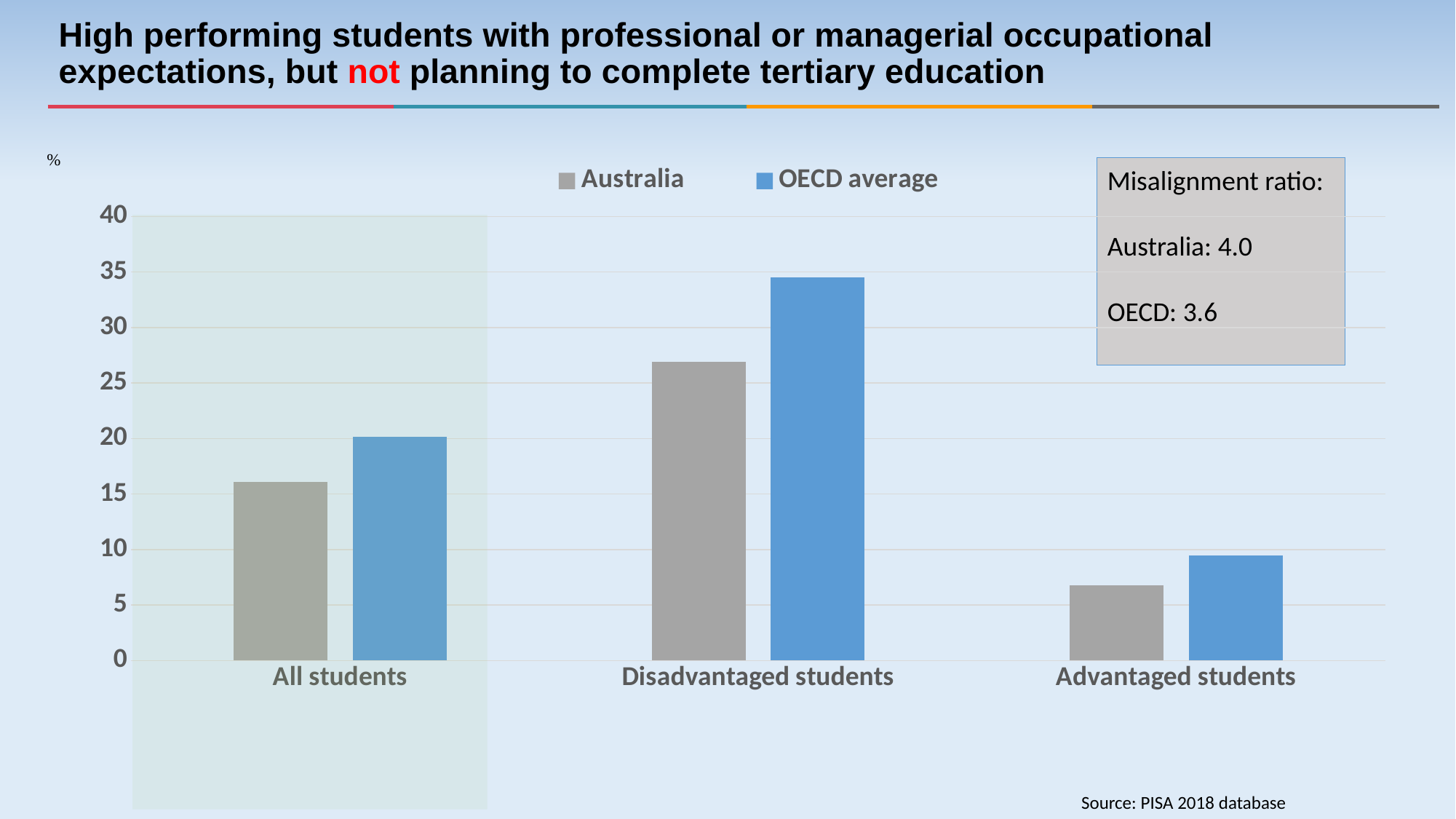
Is the value for Australia among All students greater or less than 20? less For All students, which is larger: Australia or OECD average? OECD average How many series does the legend list? 2 What kind of chart is shown on the slide? Bar chart Is the value for Australia among Disadvantaged students greater or less than 25? greater Is the value for Australia among Advantaged students greater or less than 10? less What misalignment ratio is given for Australia in the text box? 4.0 Which bar is the lowest in the chart? Australia for Advantaged students For Disadvantaged students, which is larger: Australia or OECD average? OECD average Which bar is the highest in the chart? OECD average for Disadvantaged students How many student categories are shown on the x axis? 3